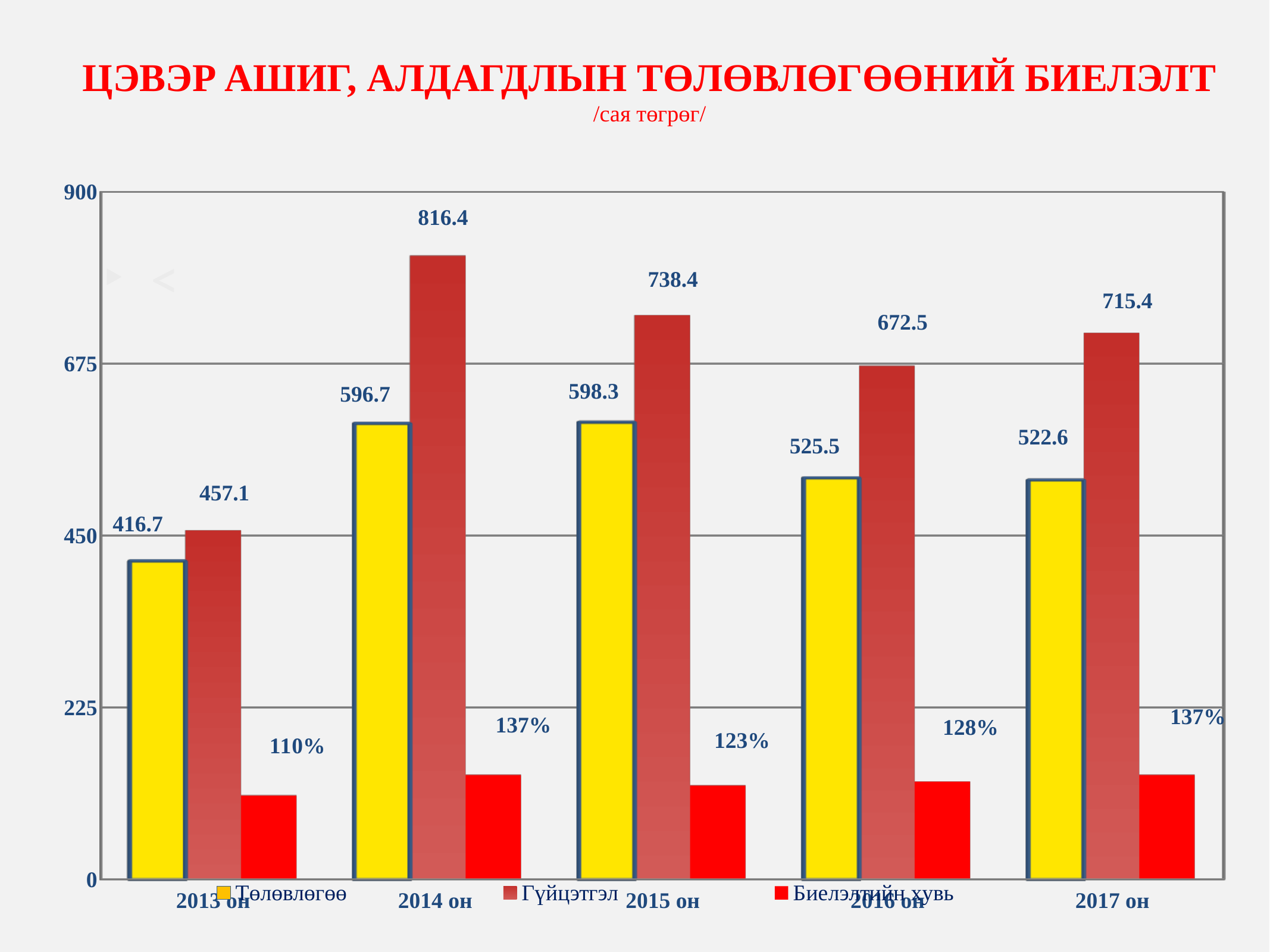
What is the Гүйцэтгэл value for 2014 он? 816.4 How many series does the legend list? 3 How many years are shown on the x axis? 5 Which is larger for 2013 он: the Төлөвлөгөө value or the Гүйцэтгэл value? Гүйцэтгэл Which year has the lowest Төлөвлөгөө value? 2013 он Which year has the highest Гүйцэтгэл value? 2014 он What is the difference between the Гүйцэтгэл and Төлөвлөгөө values for 2017 он? 192.8 Is the Гүйцэтгэл value for 2016 он greater or less than 450? greater What is the Төлөвлөгөө value for 2016 он? 525.5 What kind of chart is shown on the slide? bar chart What is the Биелэлтийн хувь value for 2015 он? 123% What unit is given below the chart title? сая төгрөг